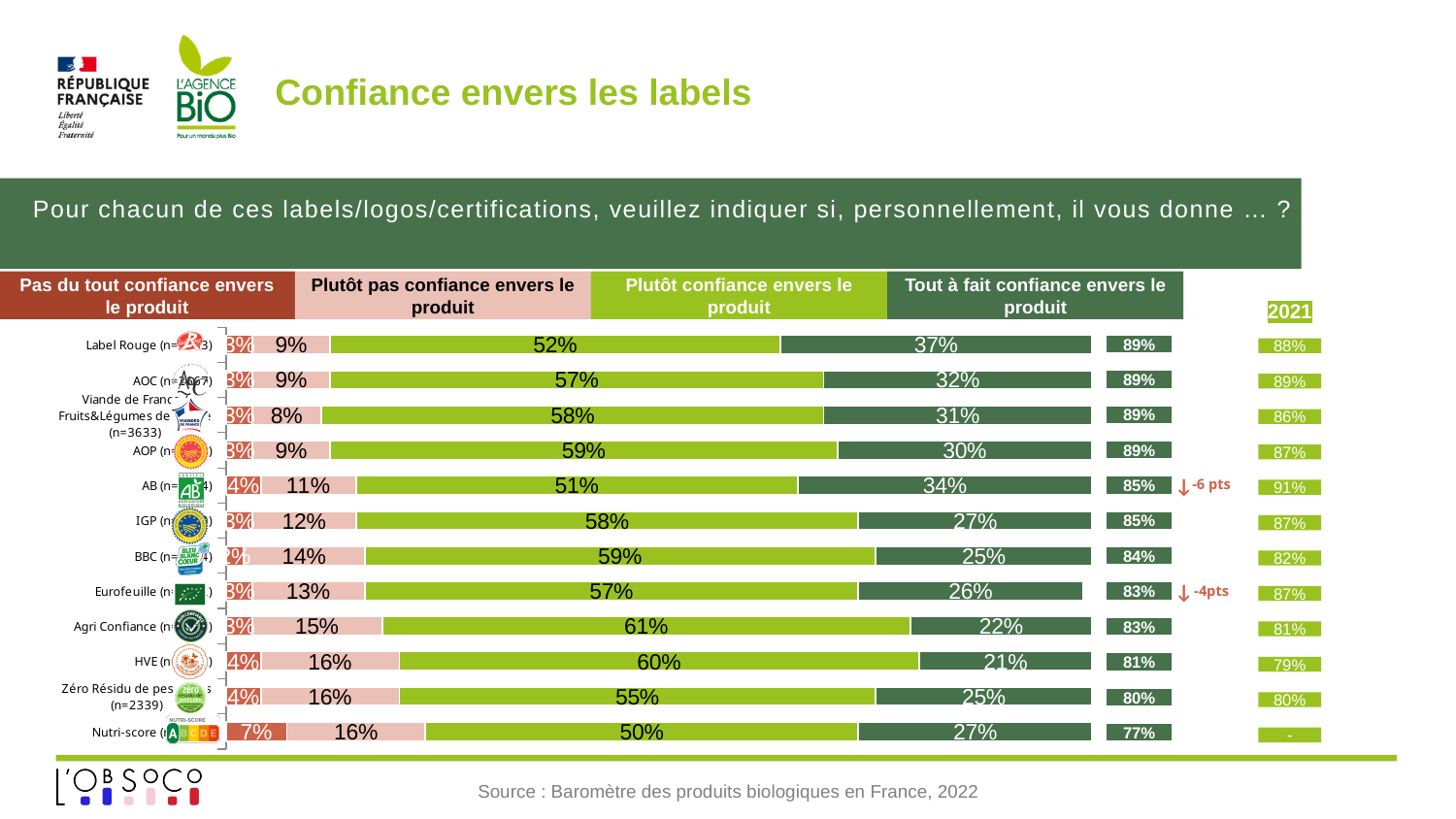
How many series does the legend list? 4 What is the combined share of "Plutôt confiance" and "Tout à fait confiance" for HVE, as printed at the end of the bar? 81% What is the value of "Pas du tout confiance envers le produit" for Nutri-score? 7% What is the value of "Plutôt confiance envers le produit" for Label Rouge? 52% Which label has the lowest "Tout à fait confiance envers le produit" value? HVE What is the difference between the "Plutôt confiance envers le produit" values for Agri Confiance and Nutri-score? 11% What is the value of "Tout à fait confiance envers le produit" for AB? 34% How many labels (categories) are plotted in the chart? 12 What kind of chart is shown on the slide? Stacked bar chart Which label has the highest "Tout à fait confiance envers le produit" value? Label Rouge Which is larger: the "Plutôt pas confiance envers le produit" value for IGP or for BBC? BBC What was the 2021 value shown for AB? 91%